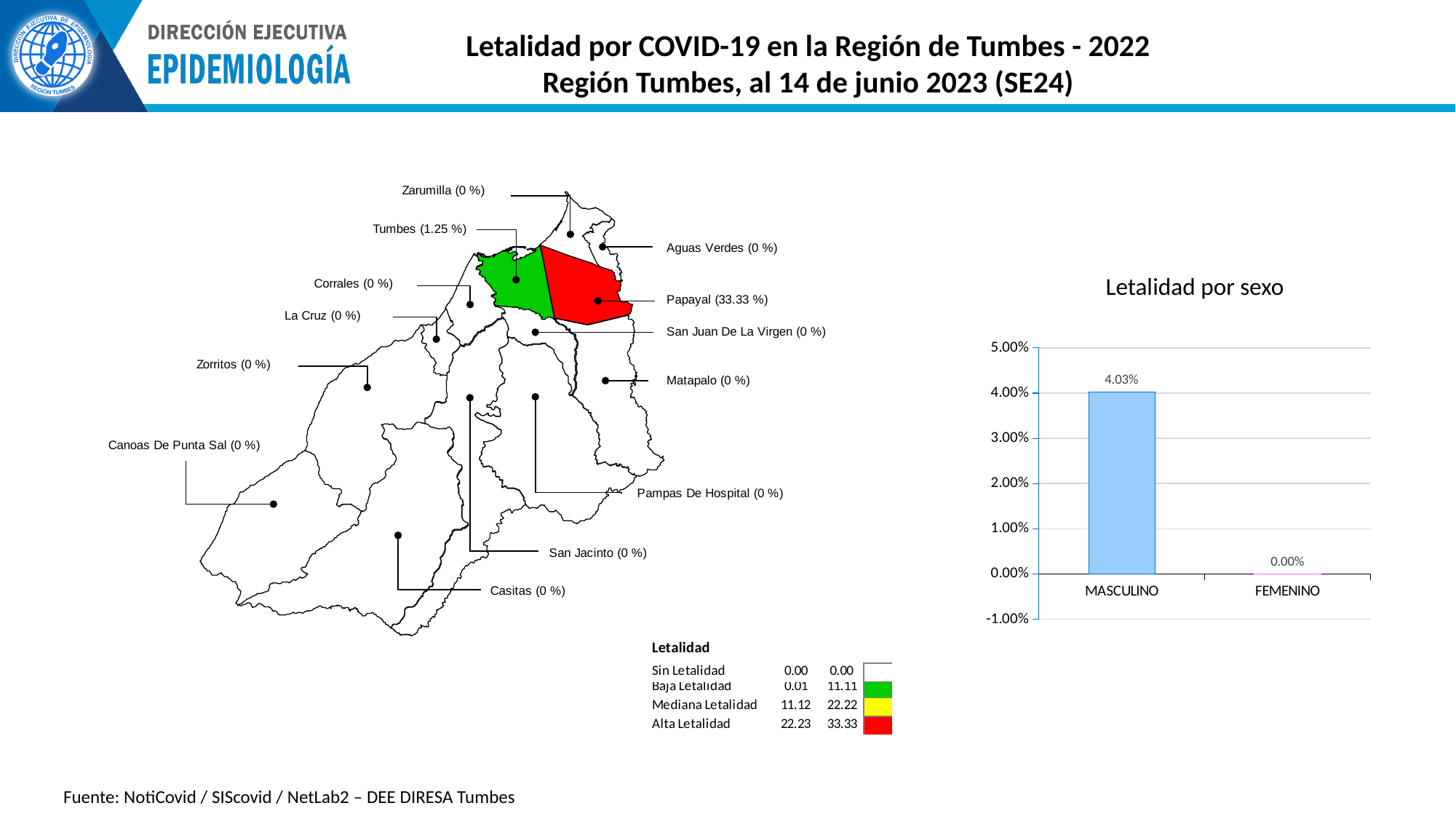
In the 'Letalidad por sexo' chart, what is the value for MASCULINO? 4.03% In the 'Letalidad por sexo' chart, what is the difference between the MASCULINO and FEMENINO values? 4.03% On the map on the left, which district has the highest lethality percentage? Papayal In the 'Letalidad por sexo' chart, which category has the lowest value? FEMENINO In the 'Letalidad por sexo' chart, is the value for MASCULINO greater or less than 3.00%? greater In the 'Letalidad por sexo' chart, what is the value for FEMENINO? 0.00% On the map on the left, what lethality percentage is shown for Papayal? 33.33 % What kind of chart is 'Letalidad por sexo'? bar chart How many categories are shown in the 'Letalidad por sexo' chart? 2 On the map on the left, what lethality percentage is shown for Tumbes? 1.25 % In the 'Letalidad por sexo' chart, which category has the highest value? MASCULINO What is the title of the chart on the right side of the slide? Letalidad por sexo